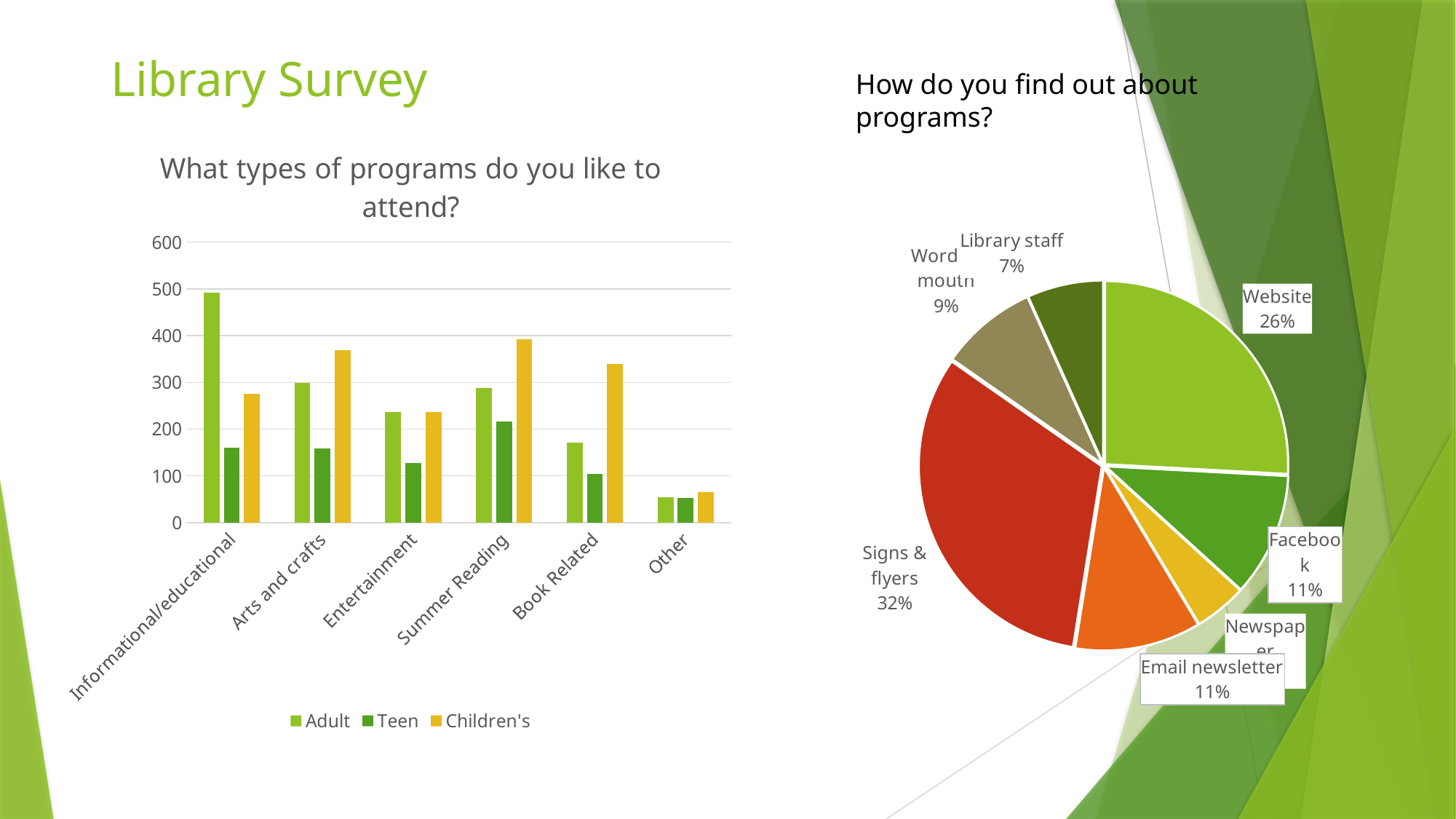
What kind of chart is "What types of programs do you like to attend?"? bar chart In the "What types of programs do you like to attend?" chart, is the Teen value for Book Related greater or less than 200? less In the "How do you find out about programs?" pie chart, what share is Website? 26% In the "What types of programs do you like to attend?" chart, is the Adult value for Informational/educational greater or less than 400? greater In the "What types of programs do you like to attend?" chart, which category has the highest Adult value? Informational/educational In the "How do you find out about programs?" pie chart, what is the difference between the Signs & flyers share and the Library staff share? 25% In the "How do you find out about programs?" pie chart, what share is Signs & flyers? 32% What kind of chart is "How do you find out about programs?"? pie chart In the "What types of programs do you like to attend?" chart, which is larger for Arts and crafts: the Adult value or the Children's value? Children's In the "What types of programs do you like to attend?" chart, how many program categories are shown on the x axis? 6 In the "What types of programs do you like to attend?" chart, how many series does the legend list? 3 In the "What types of programs do you like to attend?" chart, which category has the highest Children's value? Summer Reading